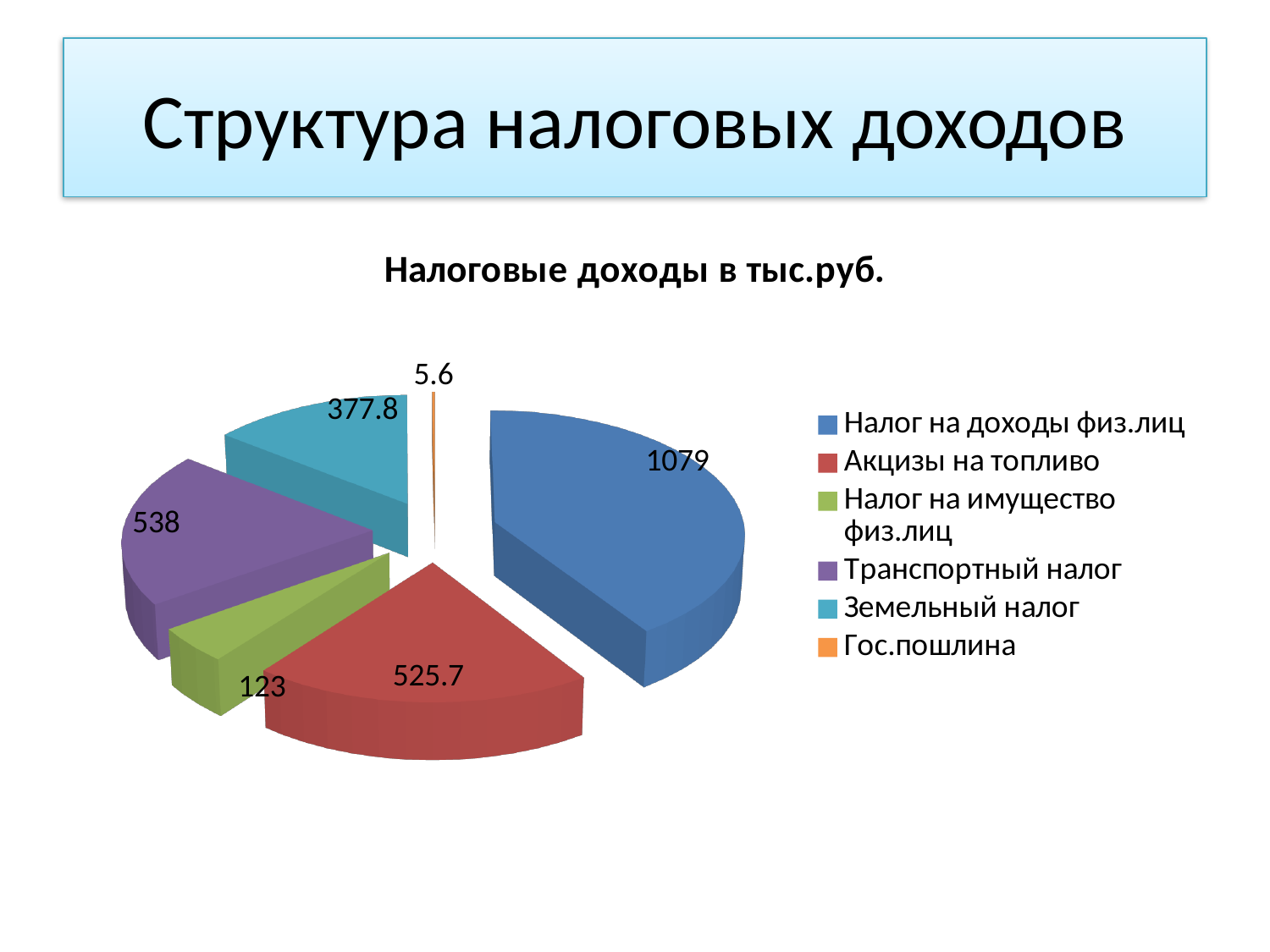
Which is larger, Транспортный налог or Акцизы на топливо? Транспортный налог How many categories does the legend list? 6 Which category has the largest value? Налог на доходы физ.лиц What is the value for Налог на доходы физ.лиц? 1079 What is the value for Гос.пошлина? 5.6 What is the value for Земельный налог? 377.8 Which category has the smallest value? Гос.пошлина What is the difference between Транспортный налог and Земельный налог? 160.2 What is the difference between Налог на доходы физ.лиц and Акцизы на топливо? 553.3 What is the value for Акцизы на топливо? 525.7 What type of chart is shown on the slide? Pie chart What is the title of the chart? Налоговые доходы в тыс.руб.